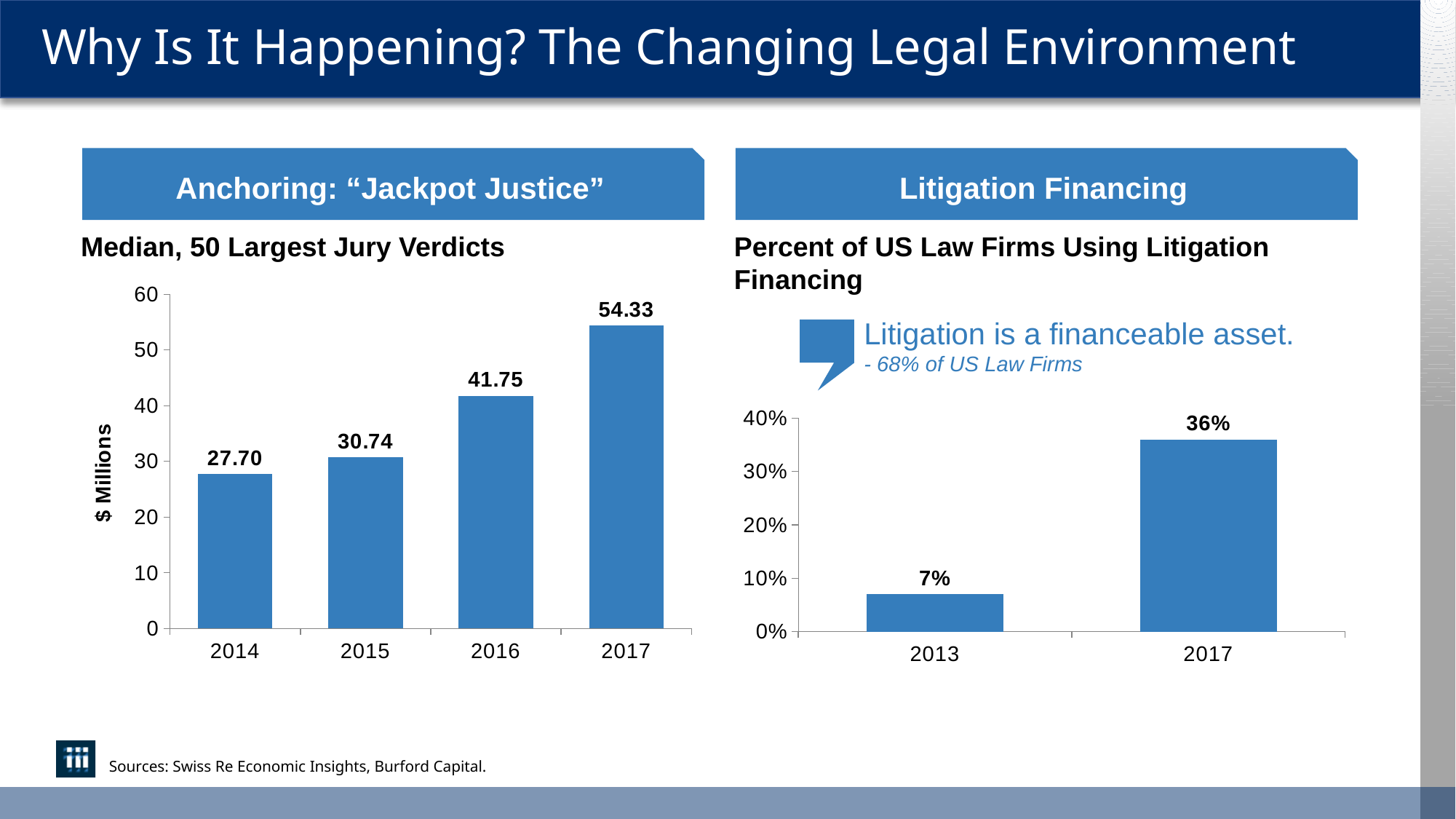
In the 'Percent of US Law Firms Using Litigation Financing' chart, what is the value for 2013? 7% What kind of chart is the 'Percent of US Law Firms Using Litigation Financing' chart? bar chart In the 'Median, 50 Largest Jury Verdicts' chart, what is the value for 2014? 27.70 In the 'Median, 50 Largest Jury Verdicts' chart, what is the value for 2016? 41.75 In the 'Median, 50 Largest Jury Verdicts' chart, which year has the highest value? 2017 In the 'Percent of US Law Firms Using Litigation Financing' chart, what is the difference between the 2017 and 2013 values? 29% In the 'Median, 50 Largest Jury Verdicts' chart, how many years are shown on the x axis? 4 In the 'Median, 50 Largest Jury Verdicts' chart, what is the y-axis label? $ Millions In the 'Percent of US Law Firms Using Litigation Financing' chart, what is the value for 2017? 36% In the 'Median, 50 Largest Jury Verdicts' chart, what is the difference between the 2017 and 2016 values? 12.58 In the 'Median, 50 Largest Jury Verdicts' chart, which year has the lowest value? 2014 In the 'Median, 50 Largest Jury Verdicts' chart, do the values rise or fall from 2014 to 2017? rise